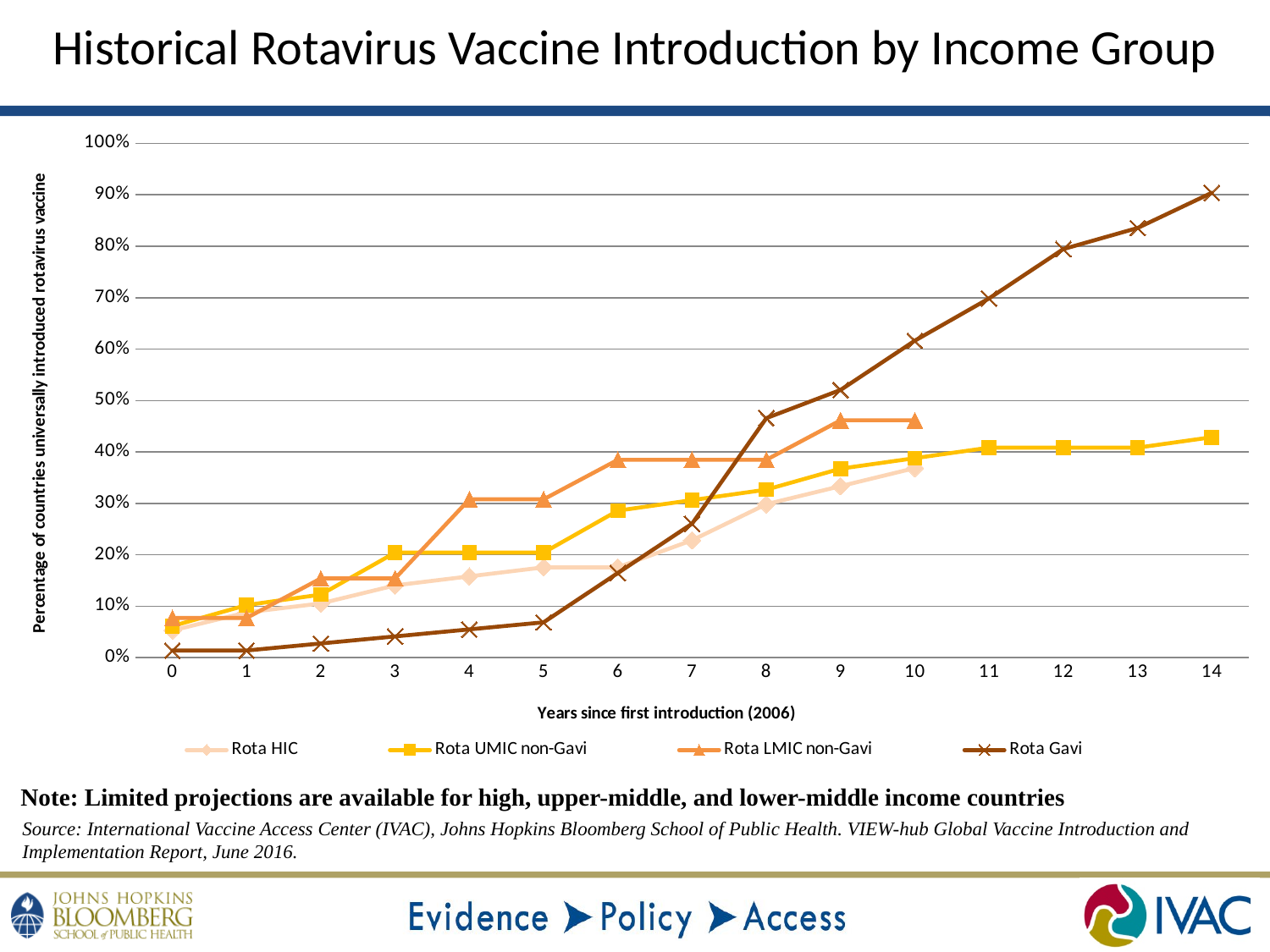
Is the value for Rota Gavi at year 13 greater or less than 80%? greater Which series has the highest value at year 14? Rota Gavi What kind of chart is shown on the slide? line chart Does the Rota Gavi series rise or fall as years since first introduction increase? rise What is the title of the x axis? Years since first introduction (2006) Is the value for Rota HIC at year 10 greater or less than 40%? less How many series does the legend list? 4 At year 5, which series has the larger value, Rota LMIC non-Gavi or Rota HIC? Rota LMIC non-Gavi Which series has the lowest value at year 0? Rota Gavi Is the value for Rota Gavi at year 8 greater or less than 50%? less How many points are marked along the x axis (years since first introduction)? 15